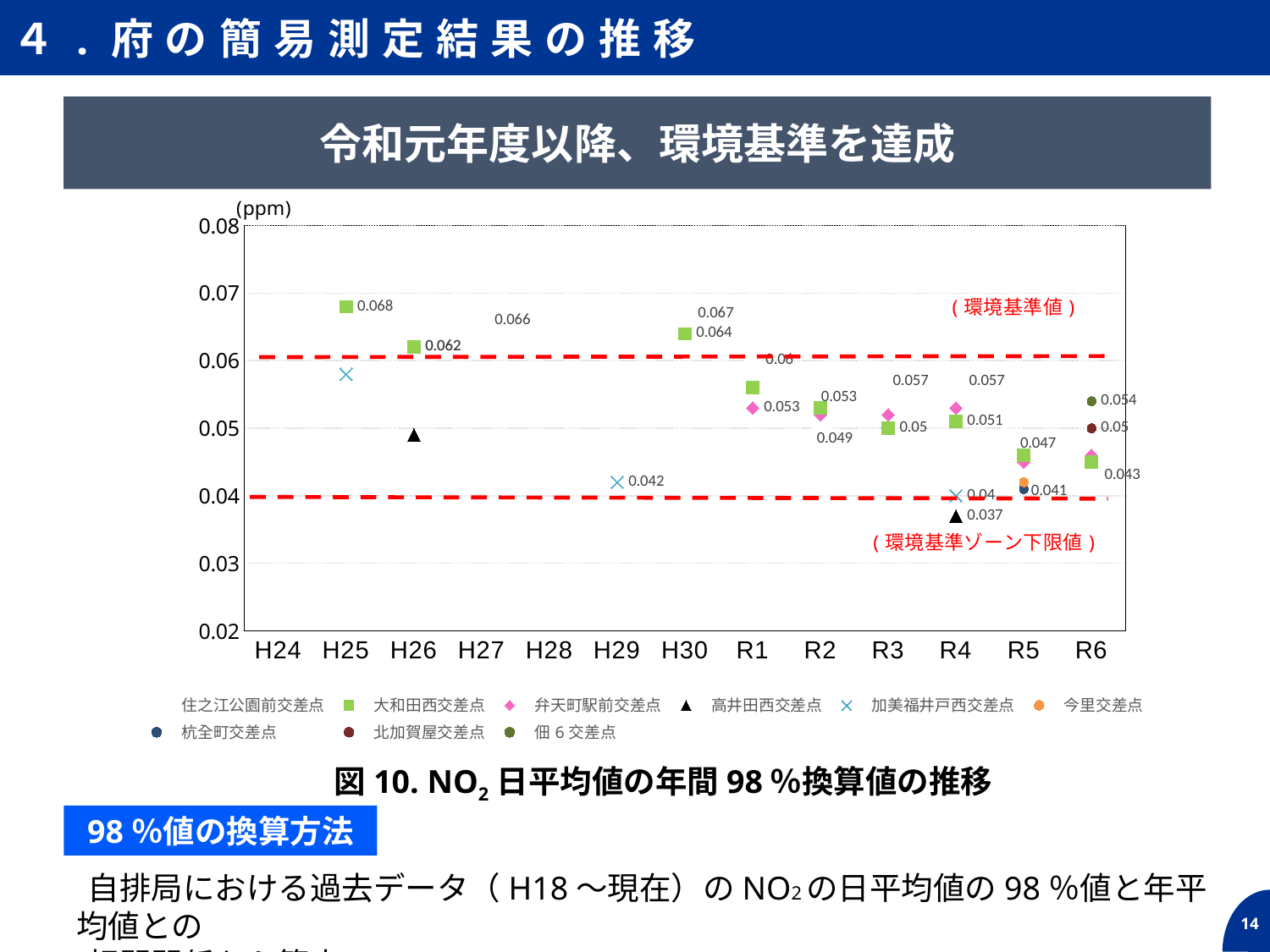
What unit is shown on the y axis of the chart? ppm How many year categories are shown on the x axis? 13 Which year has the highest plotted value in the chart? H25 What is the value for 高井田西交差点 in R4? 0.037 What is the value for 大和田西交差点 in H25? 0.068 What is the difference between the 大和田西交差点 values in H25 and H26? 0.006 What is the value for 佃6交差点 in R6? 0.054 Is the value for 加美福井戸西交差点 in H25 greater or less than 0.05? greater What is the value for 大和田西交差点 in H26? 0.062 What is the value for 加美福井戸西交差点 in H29? 0.042 What kind of chart is shown on the slide? scatter chart How many series does the legend list? 9